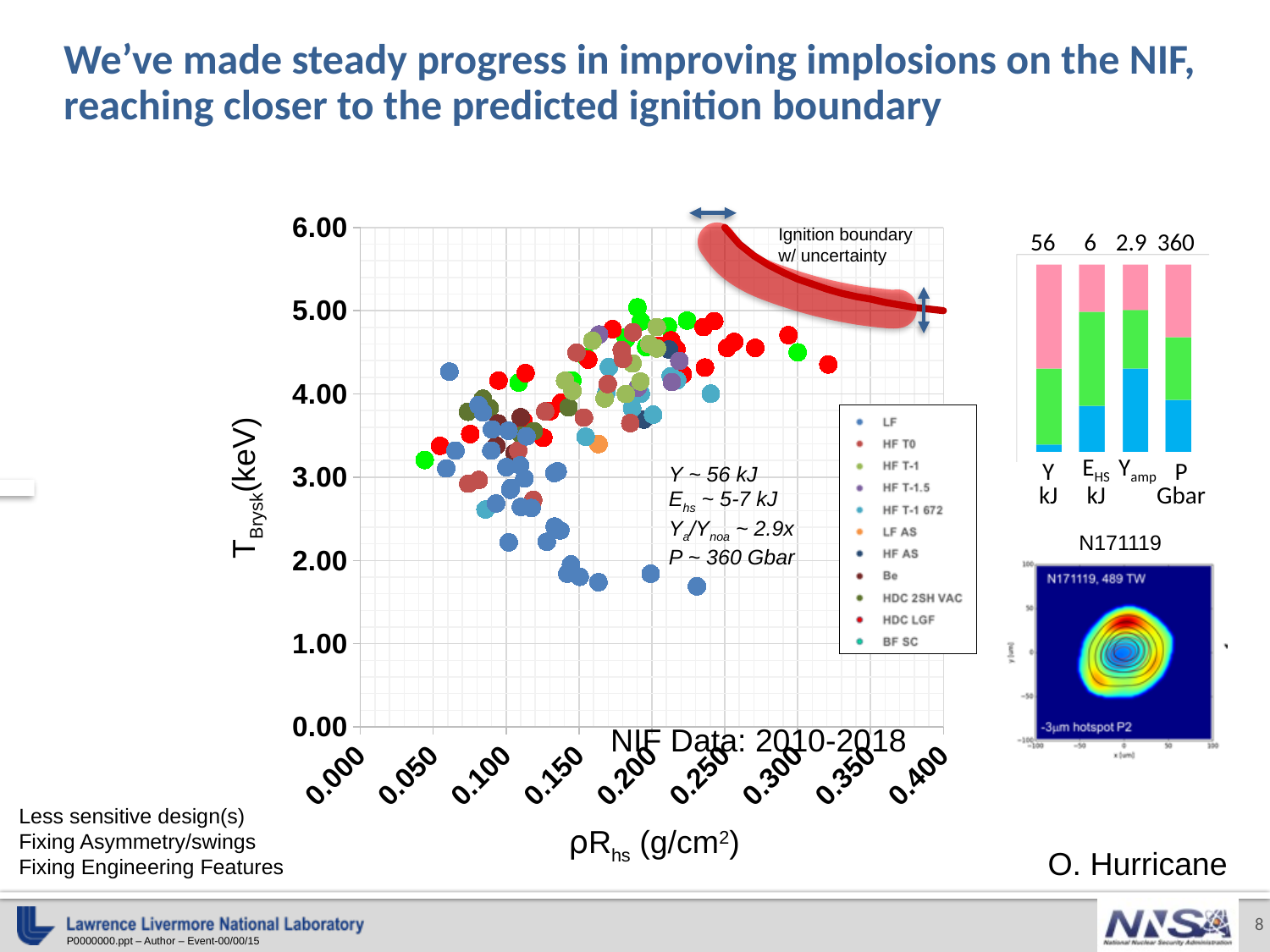
What kind of chart is the large chart in the centre of the slide? scatter chart In the small stacked bar chart on the right, what number is printed above the bar labeled P Gbar? 360 How many series does the legend of the central scatter chart list? 11 In the small stacked bar chart on the right, which bar has the largest number printed above it? P Gbar In the small stacked bar chart on the right, what number is printed above the bar labeled Y kJ? 56 What is the label of the x axis of the central scatter chart? ρR_hs (g/cm²) How many bars are in the small stacked bar chart on the right side of the slide? 4 What kind of chart is the small chart on the right side of the slide with four coloured columns? stacked bar chart What is the highest tick value shown on the y axis of the central scatter chart? 6.00 In the small stacked bar chart on the right, what number is printed above the bar labeled Y_amp? 2.9 In the small stacked bar chart on the right, which has the larger number printed above it: the Y kJ bar or the E_HS kJ bar? Y kJ